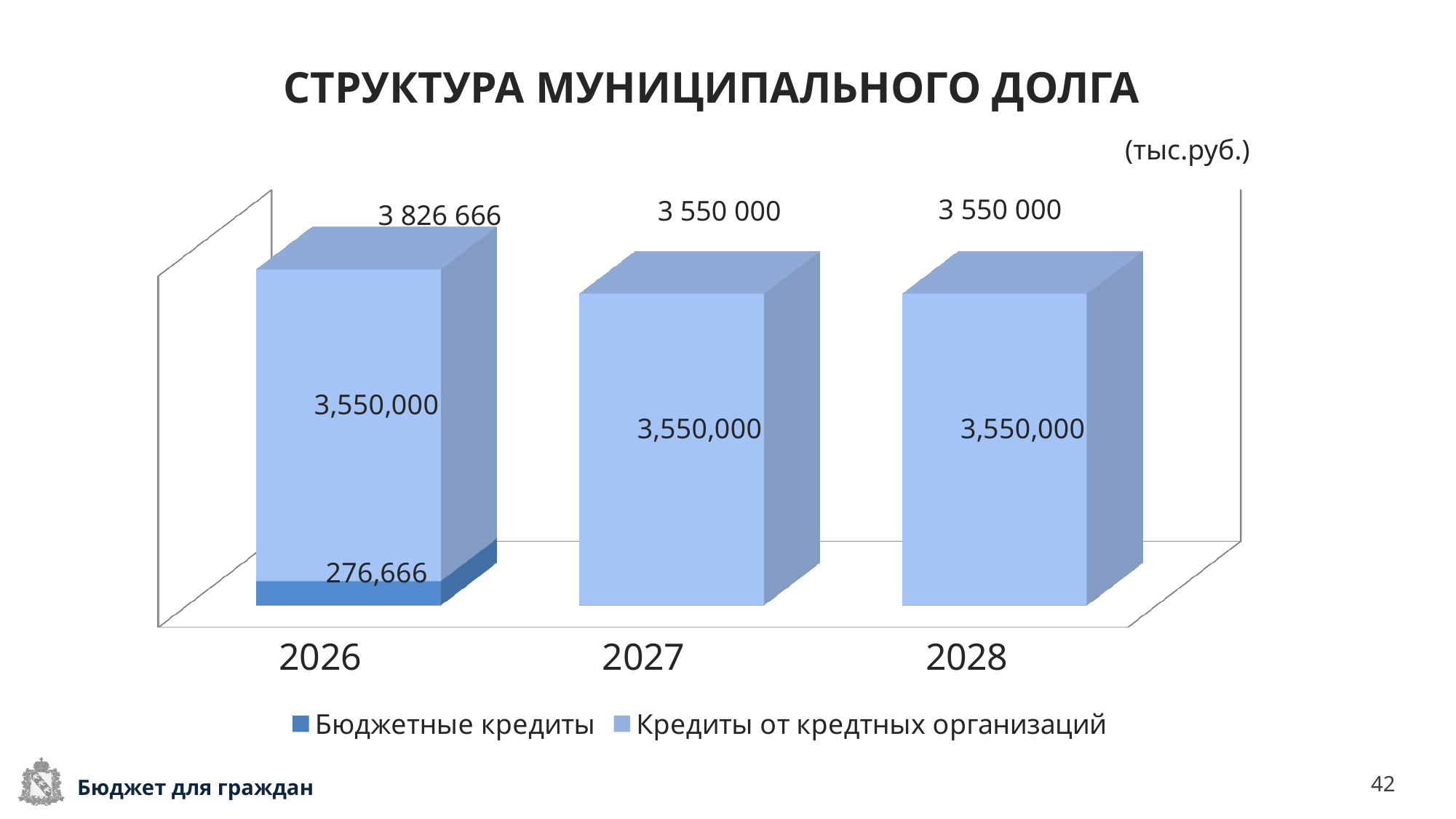
Which year has the highest total municipal debt? 2026 What is the difference between the total for 2026 and the total for 2027? 276 666 What is the title of the chart? СТРУКТУРА МУНИЦИПАЛЬНОГО ДОЛГА How many years are shown on the x axis? 3 What is the total of the stacked bar for 2026? 3 826 666 Which is larger in 2026: Бюджетные кредиты or Кредиты от кредтных организаций? Кредиты от кредтных организаций What is the value of Кредиты от кредтных организаций for 2027? 3,550,000 How many series does the legend list? 2 What kind of chart is shown on the slide? Stacked bar chart What is the value of Кредиты от кредтных организаций for 2026? 3,550,000 What is the total shown above the bar for 2028? 3 550 000 What is the value of Бюджетные кредиты for 2026? 276,666